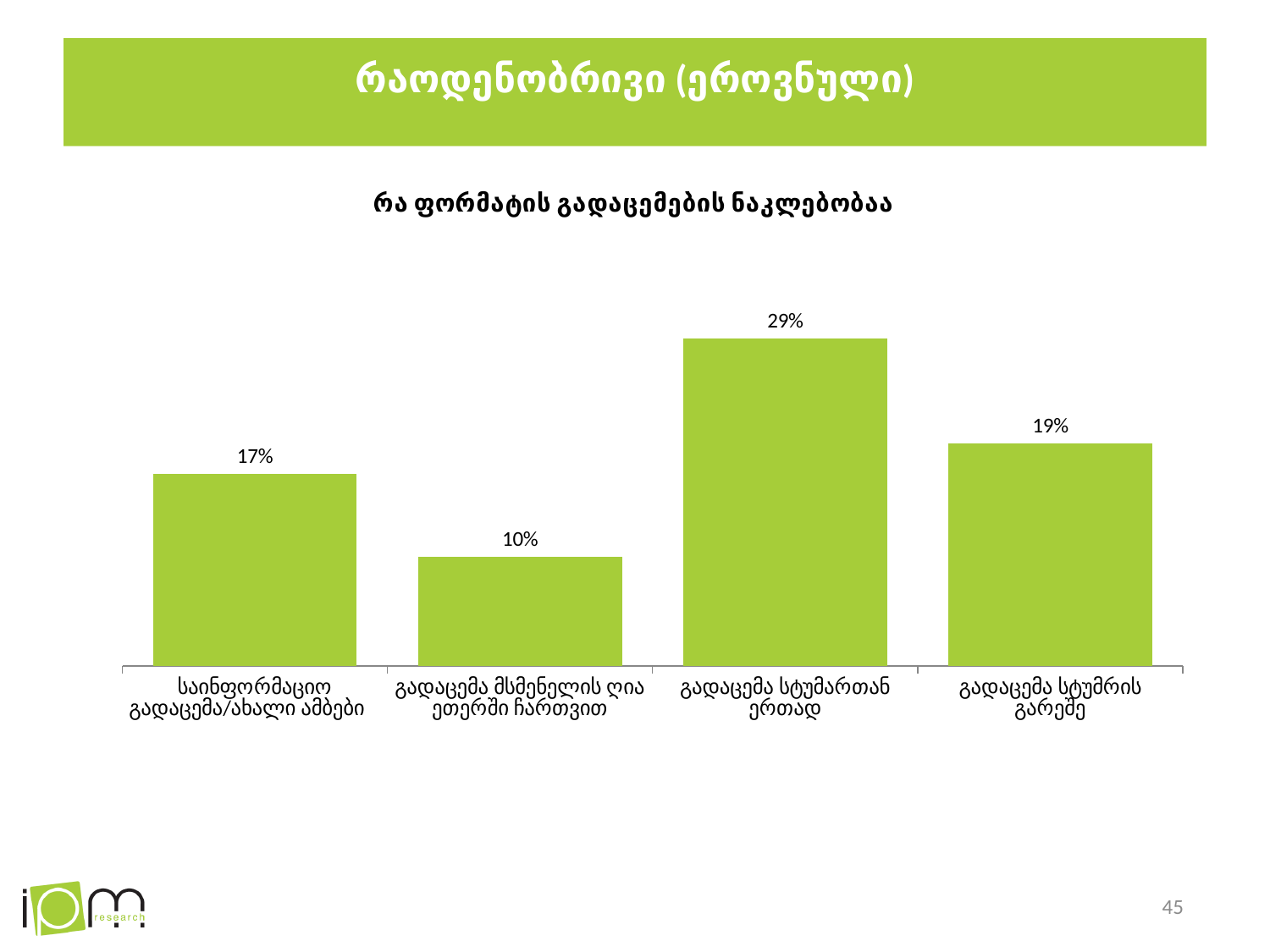
Which category has the lowest value? გადაცემა მსმენელის ღია ეთერში ჩართვით What is the difference between the values for "საინფორმაციო გადაცემა/ახალი ამბები" and "გადაცემა მსმენელის ღია ეთერში ჩართვით"? 7% How many categories are shown in the chart? 4 Which is larger: the value for "გადაცემა სტუმრის გარეშე" or for "საინფორმაციო გადაცემა/ახალი ამბები"? გადაცემა სტუმრის გარეშე What is the value for "გადაცემა სტუმრის გარეშე"? 19% What type of chart is shown on the slide? Bar chart What is the title of the chart? რა ფორმატის გადაცემების ნაკლებობაა What is the value for "საინფორმაციო გადაცემა/ახალი ამბები"? 17% What is the value for "გადაცემა სტუმართან ერთად"? 29% What is the value for "გადაცემა მსმენელის ღია ეთერში ჩართვით"? 10% What is the difference between the values for "გადაცემა სტუმართან ერთად" and "გადაცემა სტუმრის გარეშე"? 10% Which category has the highest value? გადაცემა სტუმართან ერთად